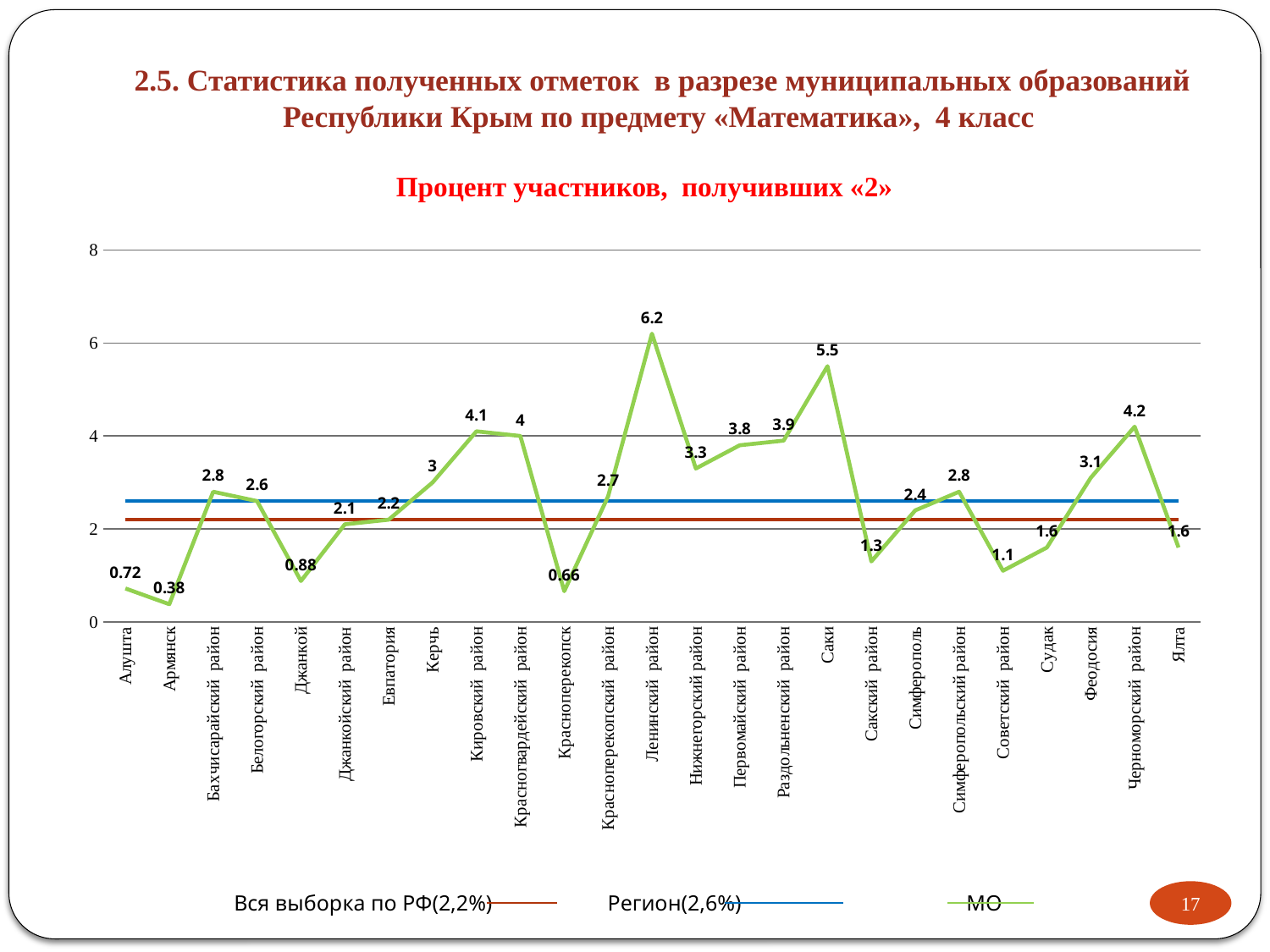
Which is larger, the value for Кировский район or the value for Черноморский район? Черноморский район What is the difference between the values for Ленинский район and Саки? 0.7 What type of chart is shown on the slide? line chart What value does the legend give for the series «Регион»? 2,6% Is the value for Керчь greater or less than 2? greater How many series does the legend list? 3 How many municipalities are plotted on the x axis? 25 What is the value for Армянск? 0.38 Which municipality has the lowest percentage of participants who received a «2»? Армянск What is the value for Саки? 5.5 What is the value for Ленинский район? 6.2 Which municipality has the highest percentage of participants who received a «2»? Ленинский район